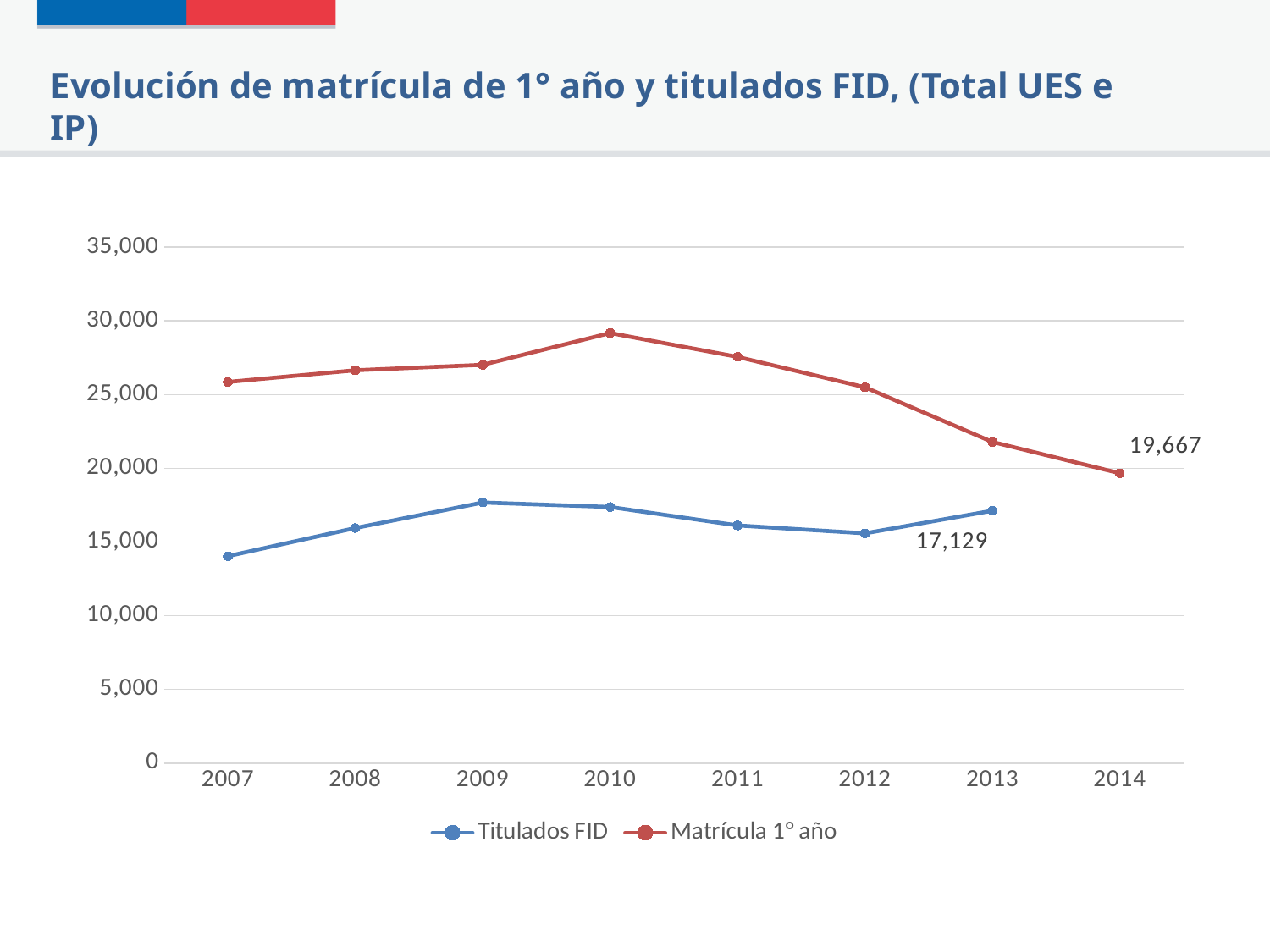
In 2010, which series has the larger value, Titulados FID or Matrícula 1° año? Matrícula 1° año What kind of chart is shown on the slide? Line chart What is the value of Titulados FID in 2013? 17,129 How many series does the legend list? 2 What is the value of Matrícula 1° año in 2014? 19,667 Does Matrícula 1° año rise or fall from 2010 to 2014? fall Is the value for Titulados FID in 2009 greater or less than 20,000? less In which year is Matrícula 1° año at its lowest? 2014 Is the value for Matrícula 1° año in 2007 greater or less than 25,000? greater In which year does Matrícula 1° año reach its highest value? 2010 In which year is Titulados FID at its lowest? 2007 How many years are shown on the x axis? 8